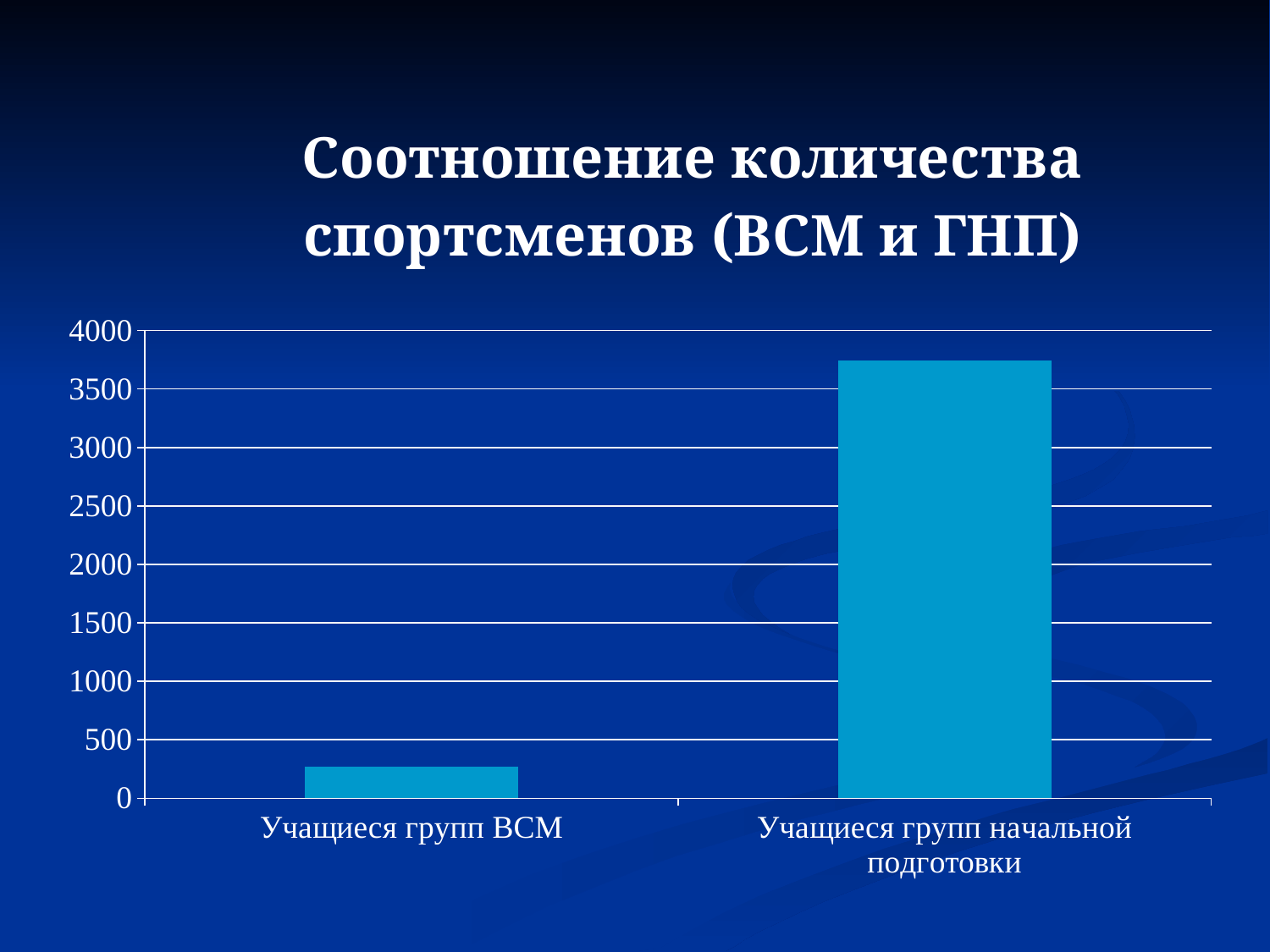
What kind of chart is shown on the slide? Bar chart Is the value for Учащиеся групп ВСМ greater or less than 500? less What is the highest value shown on the vertical axis? 4000 Is the value for Учащиеся групп ВСМ greater or less than 1000? less Which category has the lowest value? Учащиеся групп ВСМ Is the value for Учащиеся групп начальной подготовки greater or less than 3500? greater What is the title of the chart on the slide? Соотношение количества спортсменов (ВСМ и ГНП) How many categories are plotted on the chart? 2 Which is larger: the value for Учащиеся групп ВСМ or the value for Учащиеся групп начальной подготовки? Учащиеся групп начальной подготовки Which category has the highest value? Учащиеся групп начальной подготовки